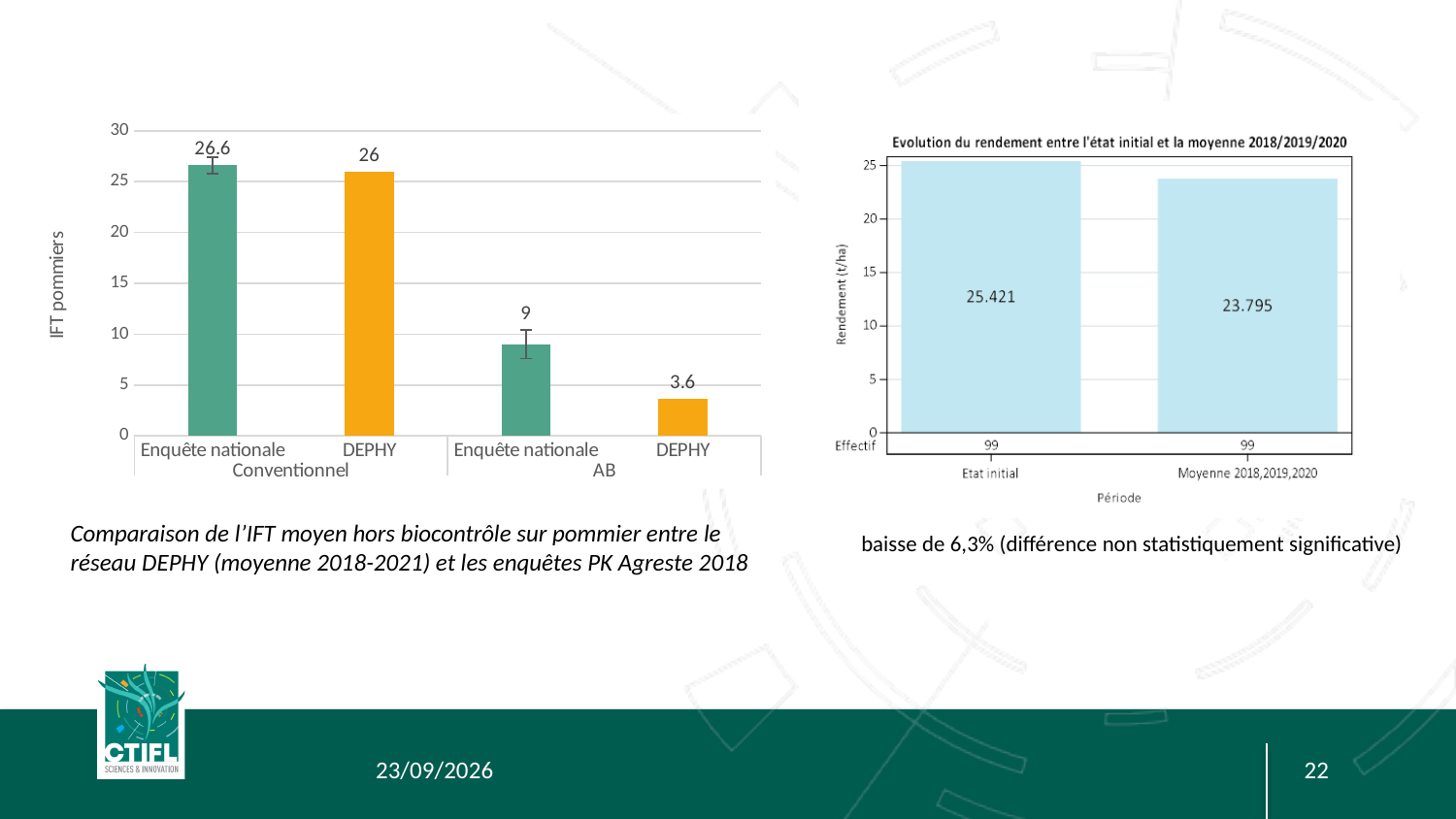
In the left chart (IFT pommiers), which bar has the lowest value? DEPHY (AB) In the left chart (IFT pommiers), what is the value for DEPHY under AB? 3.6 In the right chart (Evolution du rendement), what is the value for Moyenne 2018,2019,2020? 23.795 What kind of chart is the left chart (IFT pommiers)? Bar chart In the right chart (Evolution du rendement), which is larger: Etat initial or Moyenne 2018,2019,2020? Etat initial In the left chart (IFT pommiers), what is the value for Enquête nationale under Conventionnel? 26.6 In the right chart (Evolution du rendement), what is the value for Etat initial? 25.421 In the left chart (IFT pommiers), how many bars are plotted? 4 In the right chart (Evolution du rendement), what is the Effectif shown for each period? 99 In the left chart (IFT pommiers), what is the difference between Enquête nationale AB and DEPHY AB? 5.4 In the left chart (IFT pommiers), what is the value for Enquête nationale under AB? 9 In the left chart (IFT pommiers), which bar has the highest value? Enquête nationale (Conventionnel)